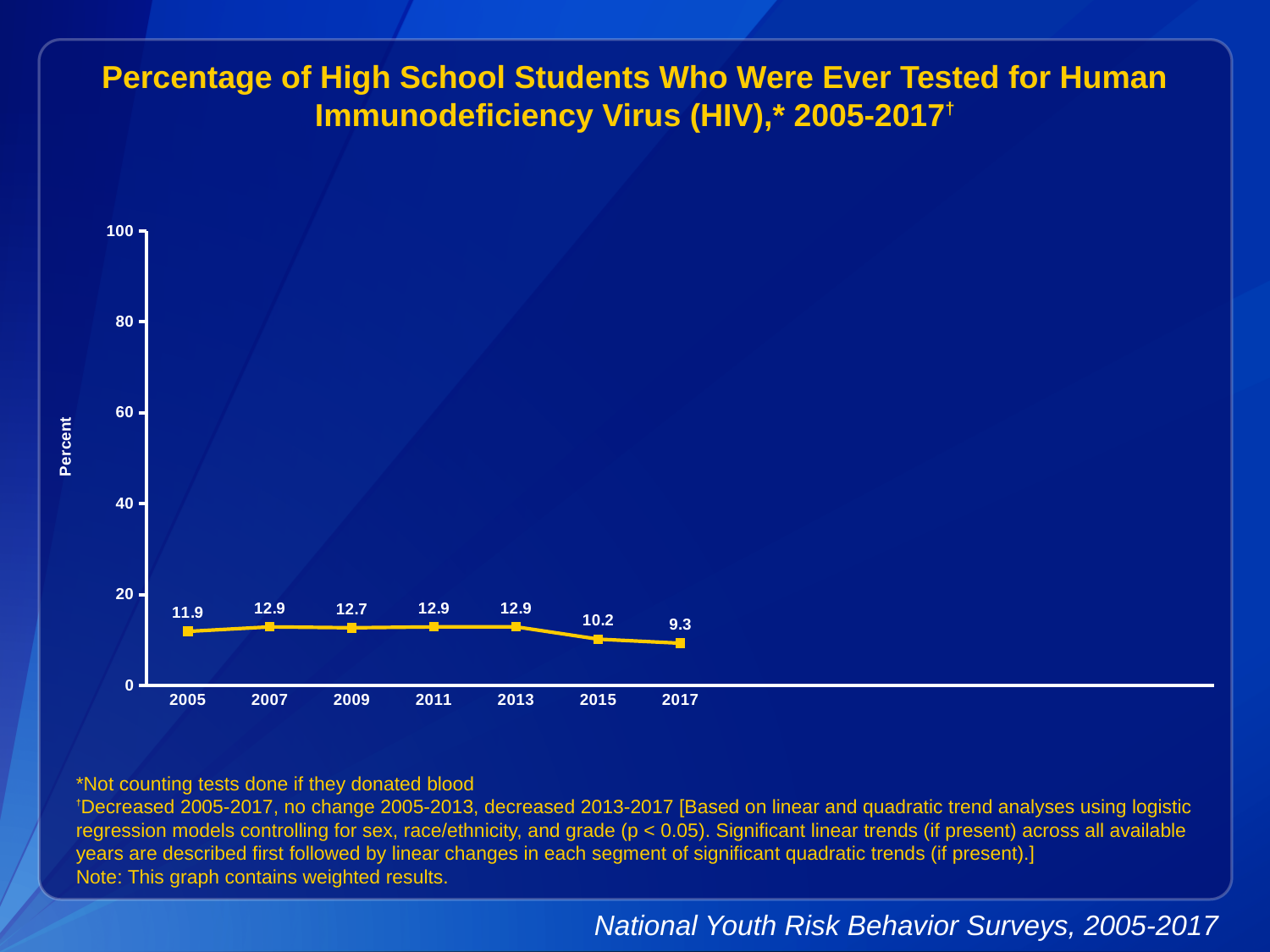
Which is larger, the value for 2009 or the value for 2015? 2009 What is the value plotted for 2015? 10.2 What is the label on the vertical axis? Percent What is the value plotted for 2017? 9.3 Do the values rise or fall from 2013 to 2017? fall What percentage of high school students were ever tested for HIV in 2005? 11.9 Which year has the lowest value on the chart? 2017 How many years are plotted on the chart? 7 What is the difference between the 2013 value and the 2017 value? 3.6 What kind of chart is shown on the slide? line chart What is the difference between the 2007 value and the 2005 value? 1.0 Is the value for 2011 greater or less than 20? less